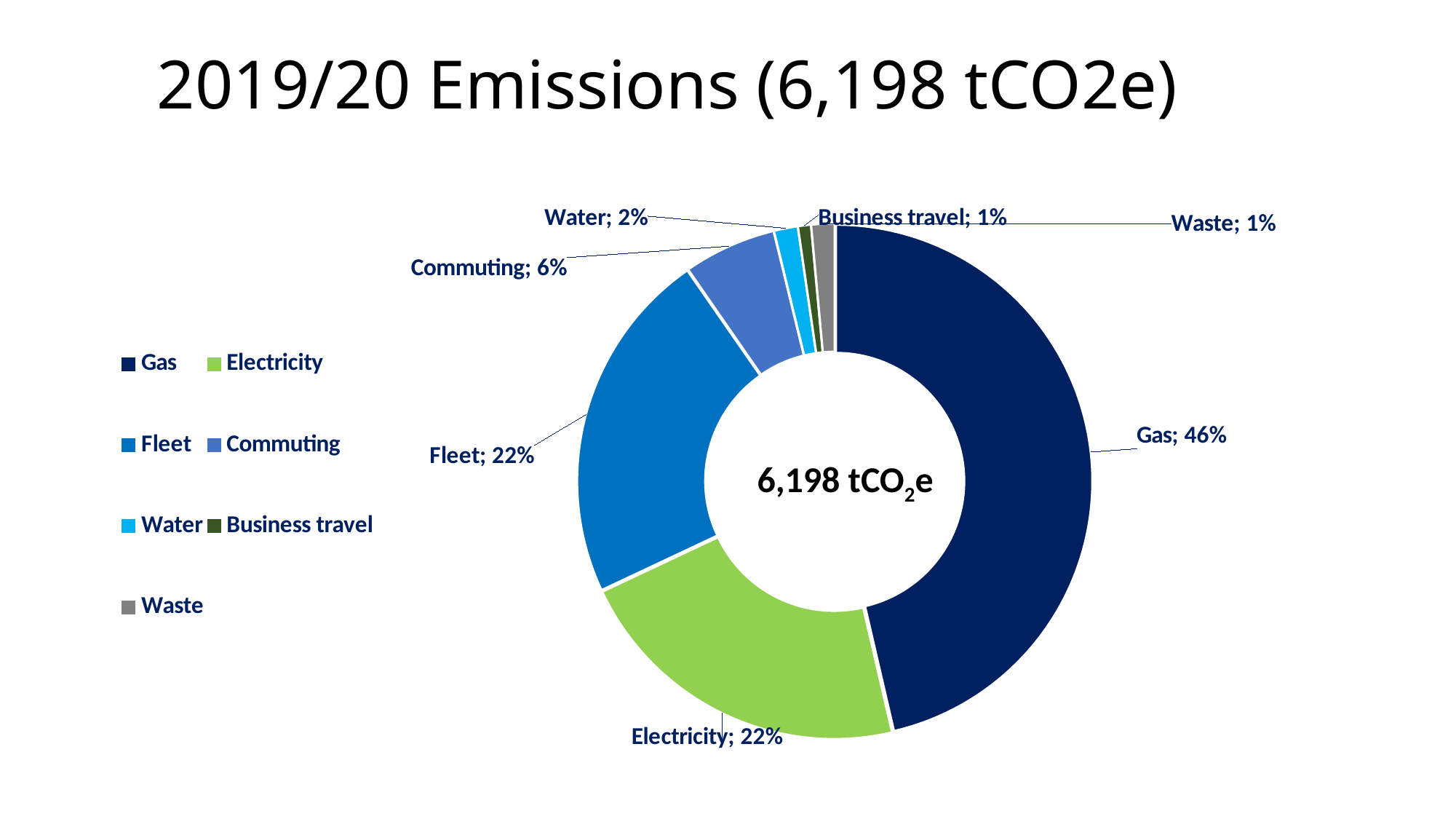
What percentage of emissions comes from Commuting? 6% What is the combined share of Fleet and Electricity? 44% How many categories are shown in the chart? 7 What share of emissions does Business travel account for? 1% Which category has the largest share of emissions? Gas What total value is printed in the centre of the chart? 6,198 tCO2e What share of emissions does Gas account for? 46% What is the share for Water? 2% What kind of chart is shown on the slide? Doughnut (pie) chart What is the title of the chart? 2019/20 Emissions (6,198 tCO2e) Which is larger, the share for Commuting or the share for Water? Commuting What is the difference in percentage points between Gas and Fleet? 24